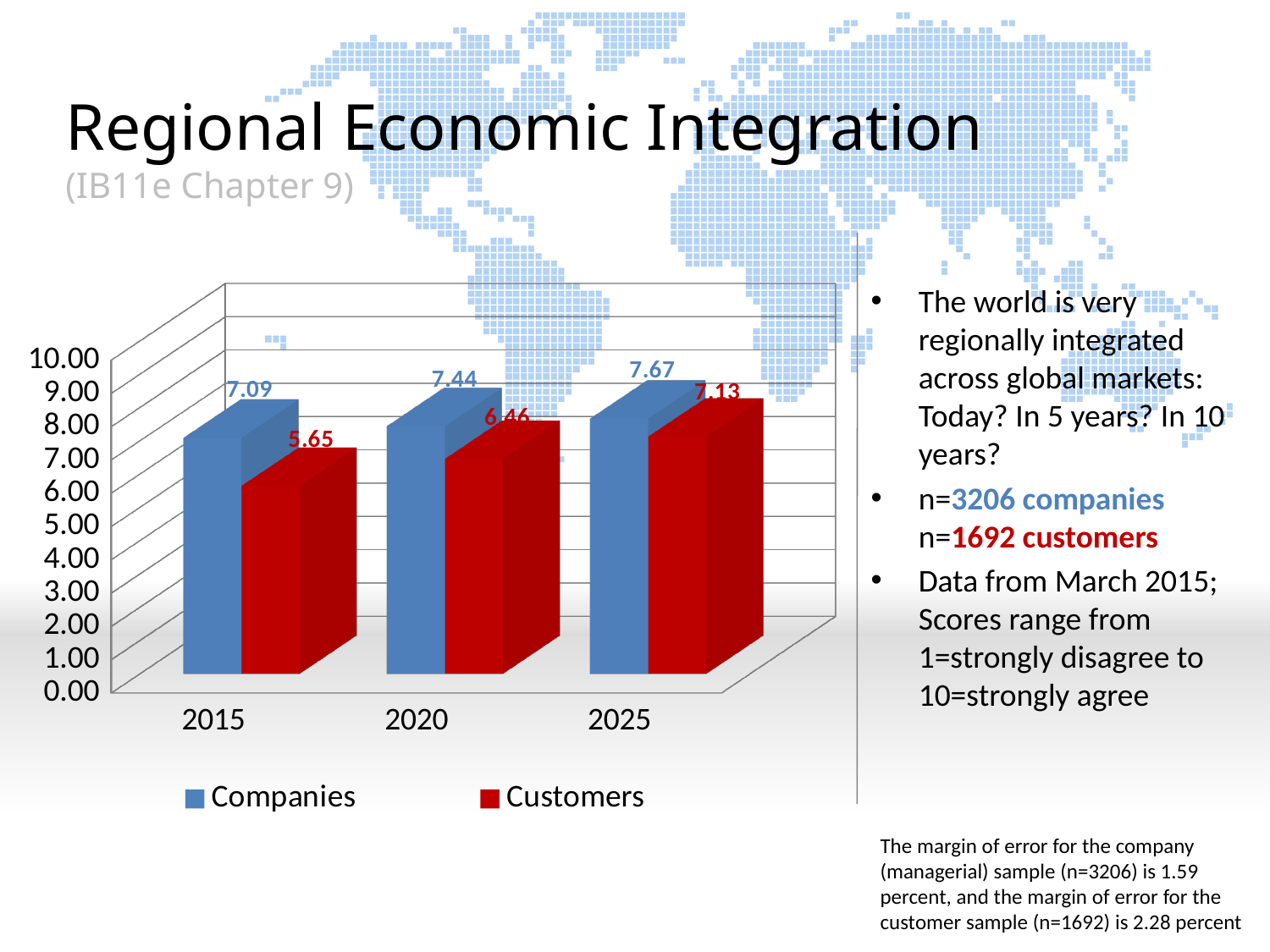
How many years are shown on the x axis of the chart? 3 What is the difference between the Companies and Customers values in 2025? 0.54 What is the value for Companies in 2015? 7.09 In which year is the Companies value highest? 2025 How many series does the chart legend list? 2 What is the value for Companies in 2025? 7.67 What kind of chart is shown on the slide? bar chart In 2020, which is larger, the Companies value or the Customers value? Companies In which year is the Customers value lowest? 2015 What is the value for Customers in 2025? 7.13 What is the difference between the Companies and Customers values in 2015? 1.44 Do the Customers values rise or fall from 2015 to 2025? rise